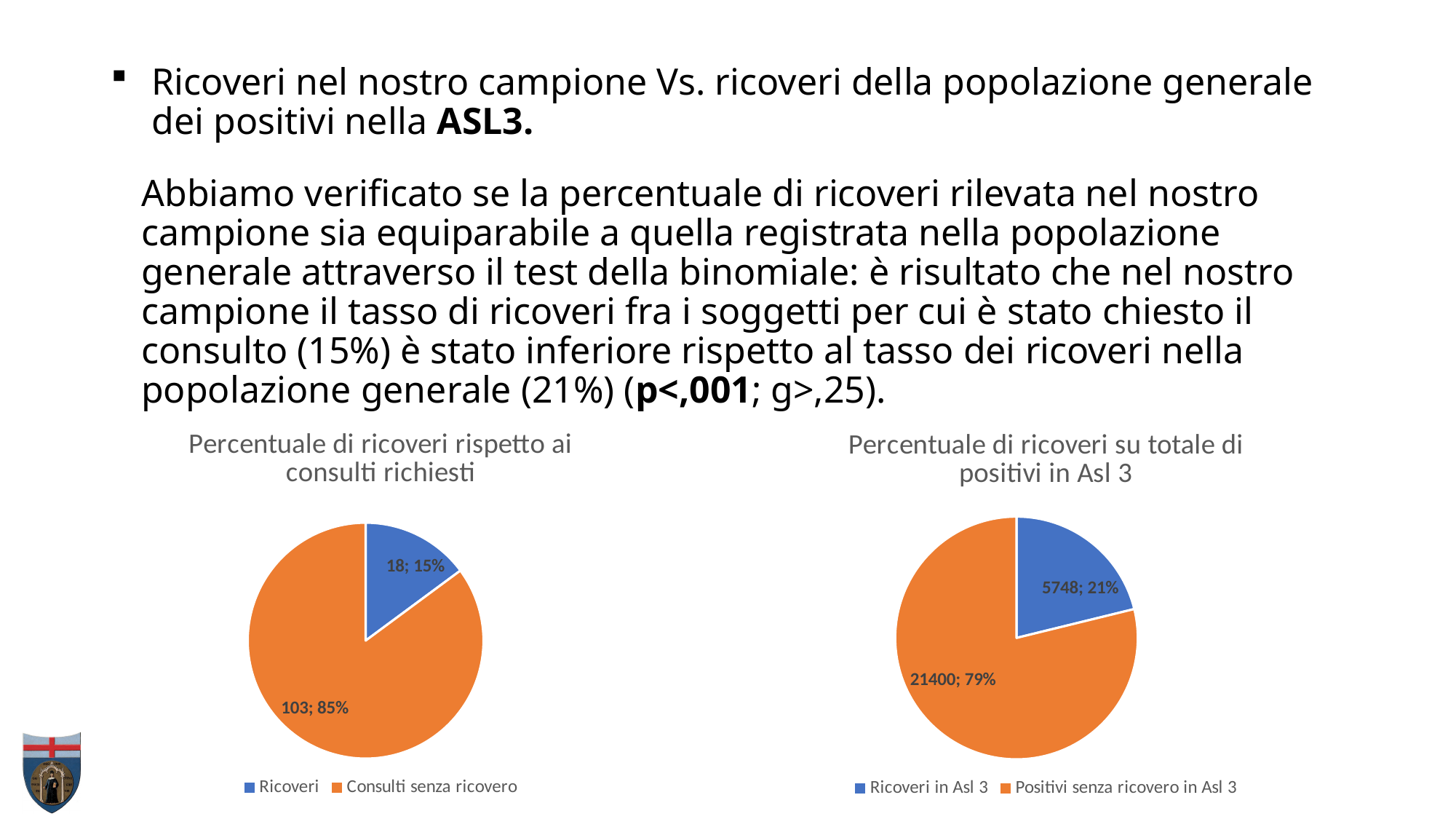
What kind of chart is the chart on the left of the slide? Pie chart In the chart 'Percentuale di ricoveri su totale di positivi in Asl 3', what is the value for Positivi senza ricovero in Asl 3? 21400 In the chart 'Percentuale di ricoveri rispetto ai consulti richiesti', what is the value for Ricoveri? 18 In the chart 'Percentuale di ricoveri su totale di positivi in Asl 3', what is the total of the two slices? 27148 In the chart 'Percentuale di ricoveri su totale di positivi in Asl 3', what is the value for Ricoveri in Asl 3? 5748 In the chart 'Percentuale di ricoveri rispetto ai consulti richiesti', what is the difference between Consulti senza ricovero and Ricoveri? 85 In the chart 'Percentuale di ricoveri rispetto ai consulti richiesti', which slice is the largest? Consulti senza ricovero How many entries does the legend of the chart 'Percentuale di ricoveri su totale di positivi in Asl 3' list? 2 In the chart 'Percentuale di ricoveri rispetto ai consulti richiesti', what share of the pie is Ricoveri? 15% In the chart 'Percentuale di ricoveri su totale di positivi in Asl 3', which slice is the smallest? Ricoveri in Asl 3 In the chart 'Percentuale di ricoveri rispetto ai consulti richiesti', what is the value for Consulti senza ricovero? 103 In the chart 'Percentuale di ricoveri su totale di positivi in Asl 3', what share of the pie is Positivi senza ricovero in Asl 3? 79%